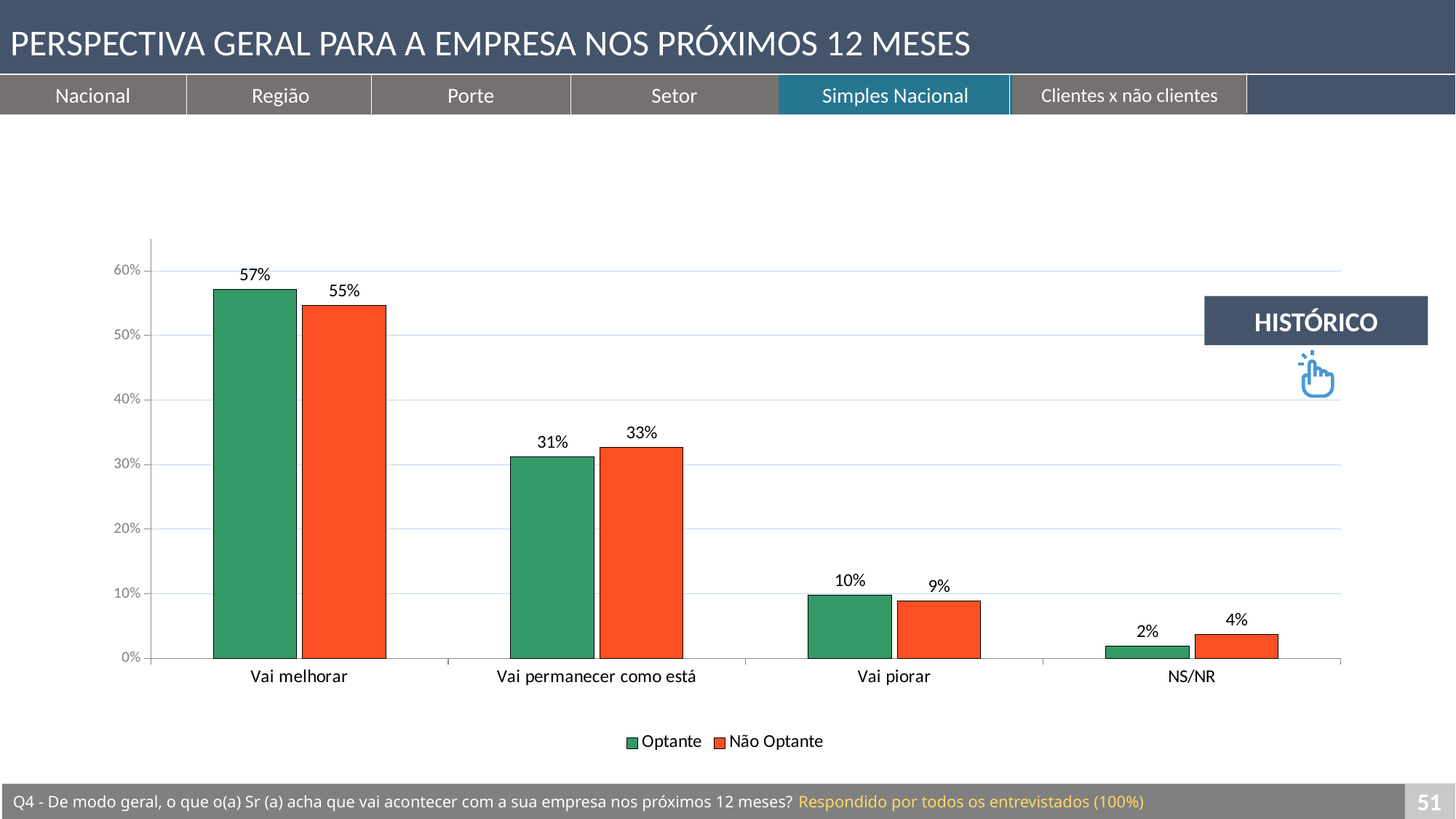
What is the value for Não Optante in the 'Vai permanecer como está' category? 33% What is the value for Não Optante in the 'NS/NR' category? 4% Which category has the highest value for the Optante series? Vai melhorar What kind of chart is shown on the slide? bar chart How many categories are shown on the x axis of the chart? 4 What is the difference between the Optante and Não Optante values in the 'Vai melhorar' category? 2% How many series does the legend list? 2 In the 'Vai permanecer como está' category, which series has the larger value, Optante or Não Optante? Não Optante Which category has the lowest value for the Não Optante series? NS/NR What is the value for Optante in the 'Vai melhorar' category? 57% Is the value for Optante in 'Vai piorar' greater or less than 20%? less Which colour represents the Não Optante series in the chart? orange